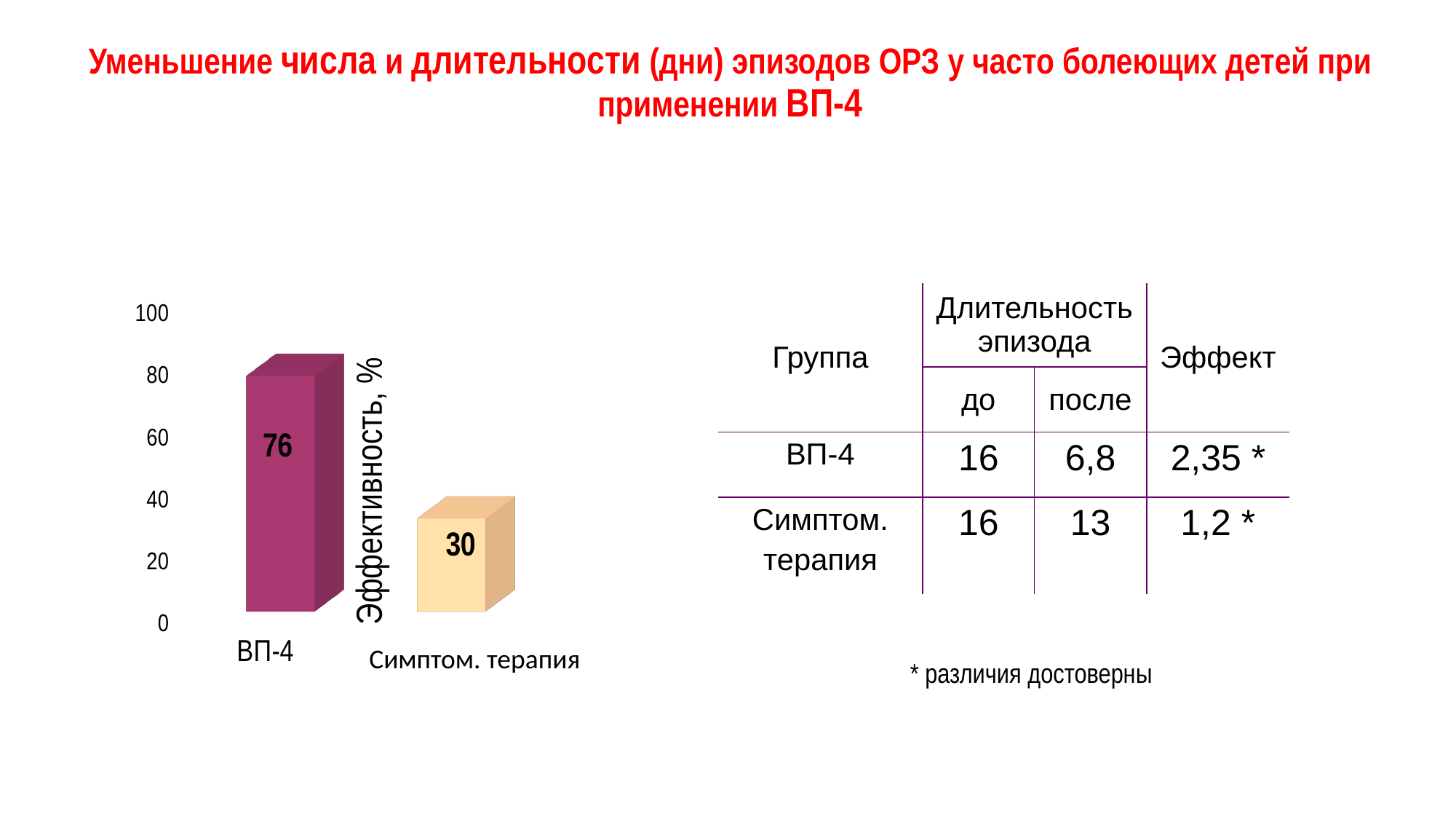
What is the maximum value shown on the vertical axis of the bar chart? 100 Which category has the highest value in the bar chart? ВП-4 How many categories are shown in the bar chart? 2 What is the value for ВП-4 in the bar chart? 76 What is the value for Симптом. терапия in the bar chart? 30 Which is larger in the bar chart: the value for ВП-4 or for Симптом. терапия? ВП-4 What is the difference between the values for ВП-4 and Симптом. терапия in the bar chart? 46 What kind of chart is shown on the slide? bar chart Which category has the lowest value in the bar chart? Симптом. терапия What is the label of the vertical axis of the bar chart? Эффективность, % Is the value for Симптом. терапия in the bar chart greater or less than 40? less Is the value for ВП-4 in the bar chart greater or less than 60? greater